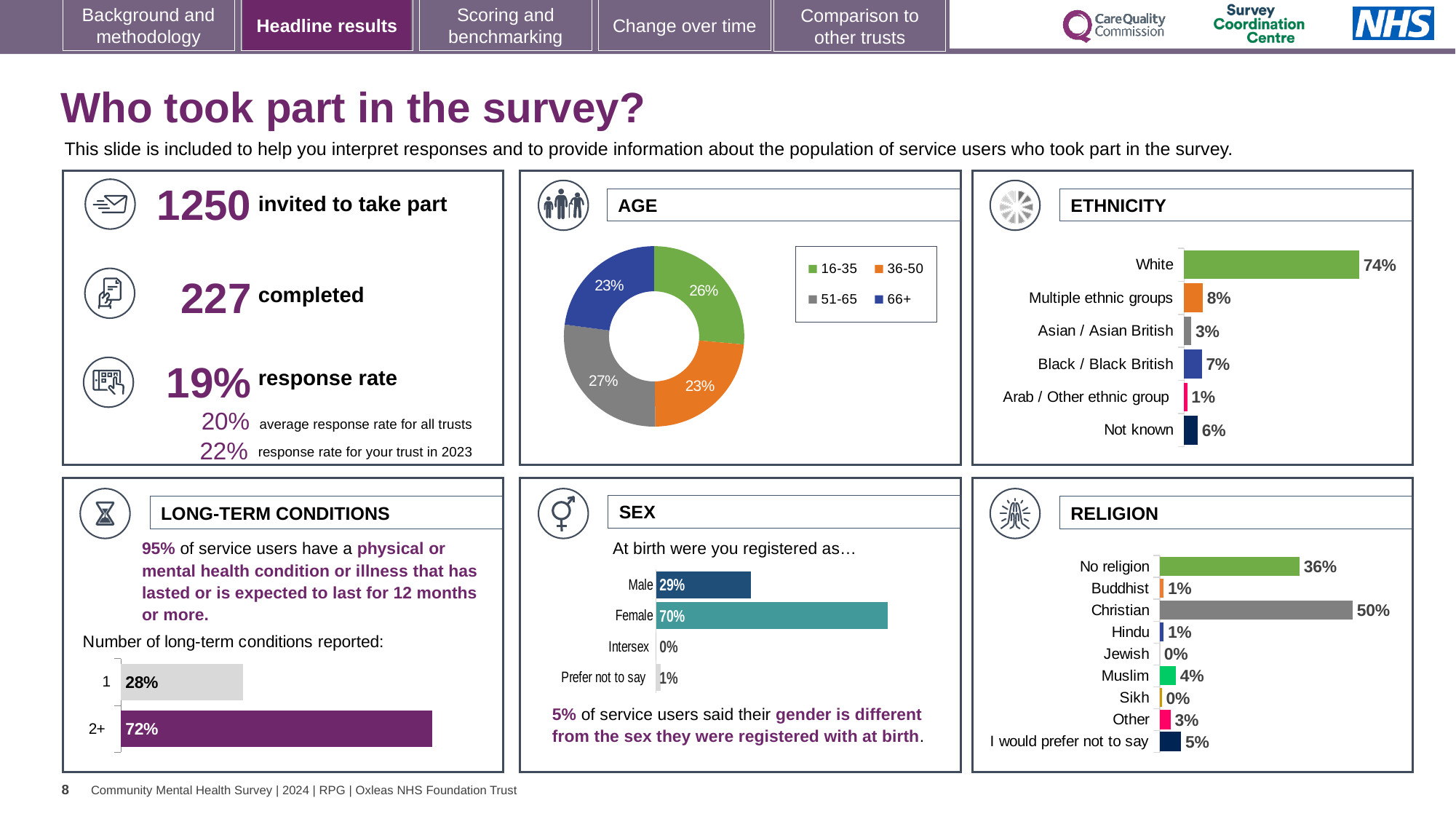
In the SEX chart, what percentage were registered as Female at birth? 70% In the LONG-TERM CONDITIONS chart, what percentage reported 2+ conditions? 72% In the AGE chart, what percentage of respondents were aged 51-65? 27% In the ETHNICITY chart, what is the difference between White and Multiple ethnic groups? 66% How many age groups does the legend of the AGE chart list? 4 What kind of chart is the AGE chart? Pie chart (donut) In the ETHNICITY chart, what is the value for Black / Black British? 7% In the RELIGION chart, which category has the highest value? Christian In the RELIGION chart, what is the value for Muslim? 4% In the SEX chart, which is larger, Male or Female? Female In the ETHNICITY chart, which category has the lowest value? Arab / Other ethnic group How many categories are shown in the ETHNICITY chart? 6